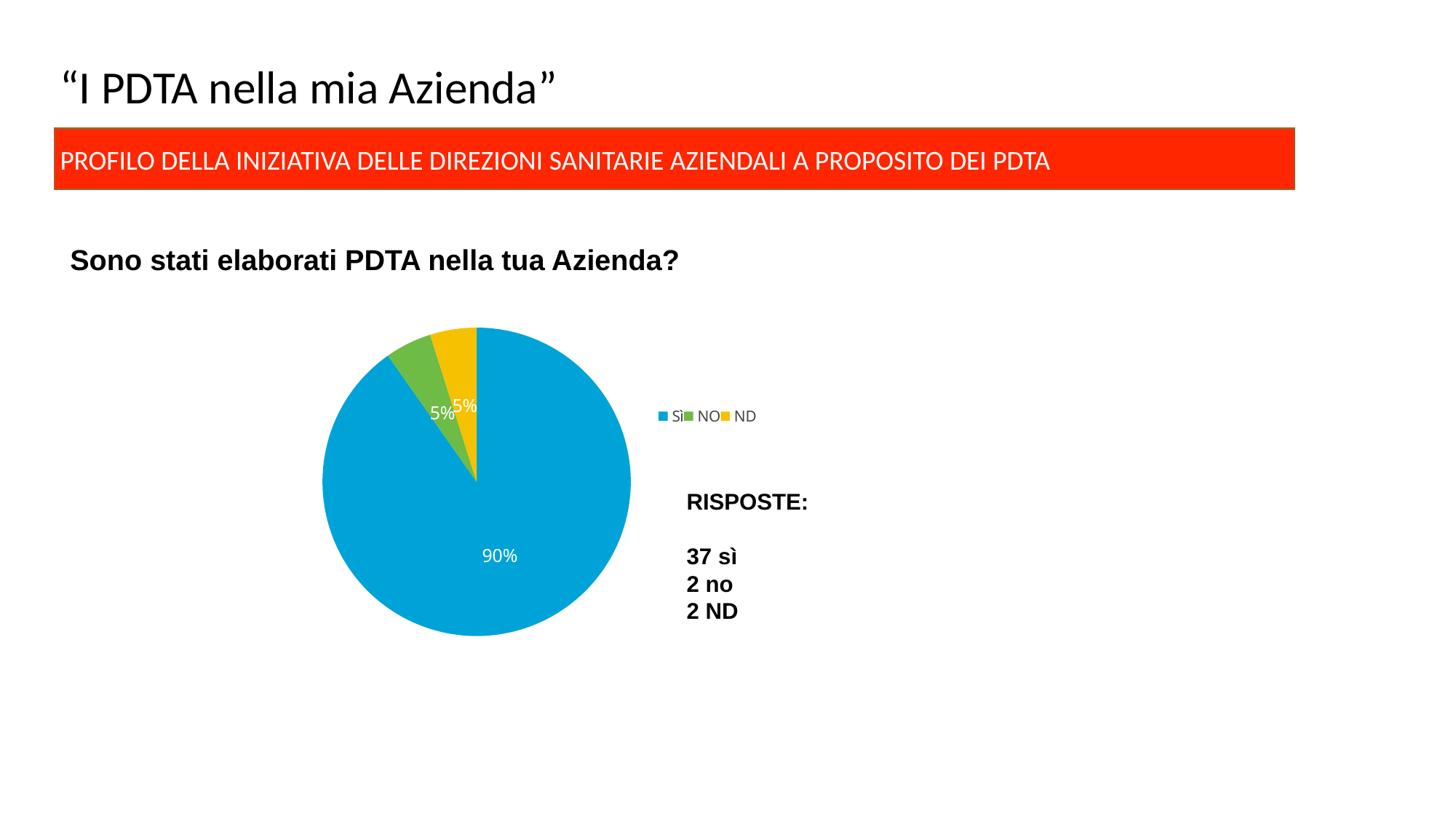
What colour is the Sì slice of the pie? blue What share of the pie does the ND slice represent? 5% What share of the pie does the Sì slice represent? 90% Which is larger, the Sì slice or the NO slice? Sì What is the difference in percentage points between the Sì slice and the ND slice? 85 Which category has the largest slice of the pie? Sì What share of the pie does the NO slice represent? 5% What colour is the ND slice of the pie? yellow What kind of chart is shown on the slide? pie chart How many entries does the legend list? 3 How many slices does the pie chart have? 3